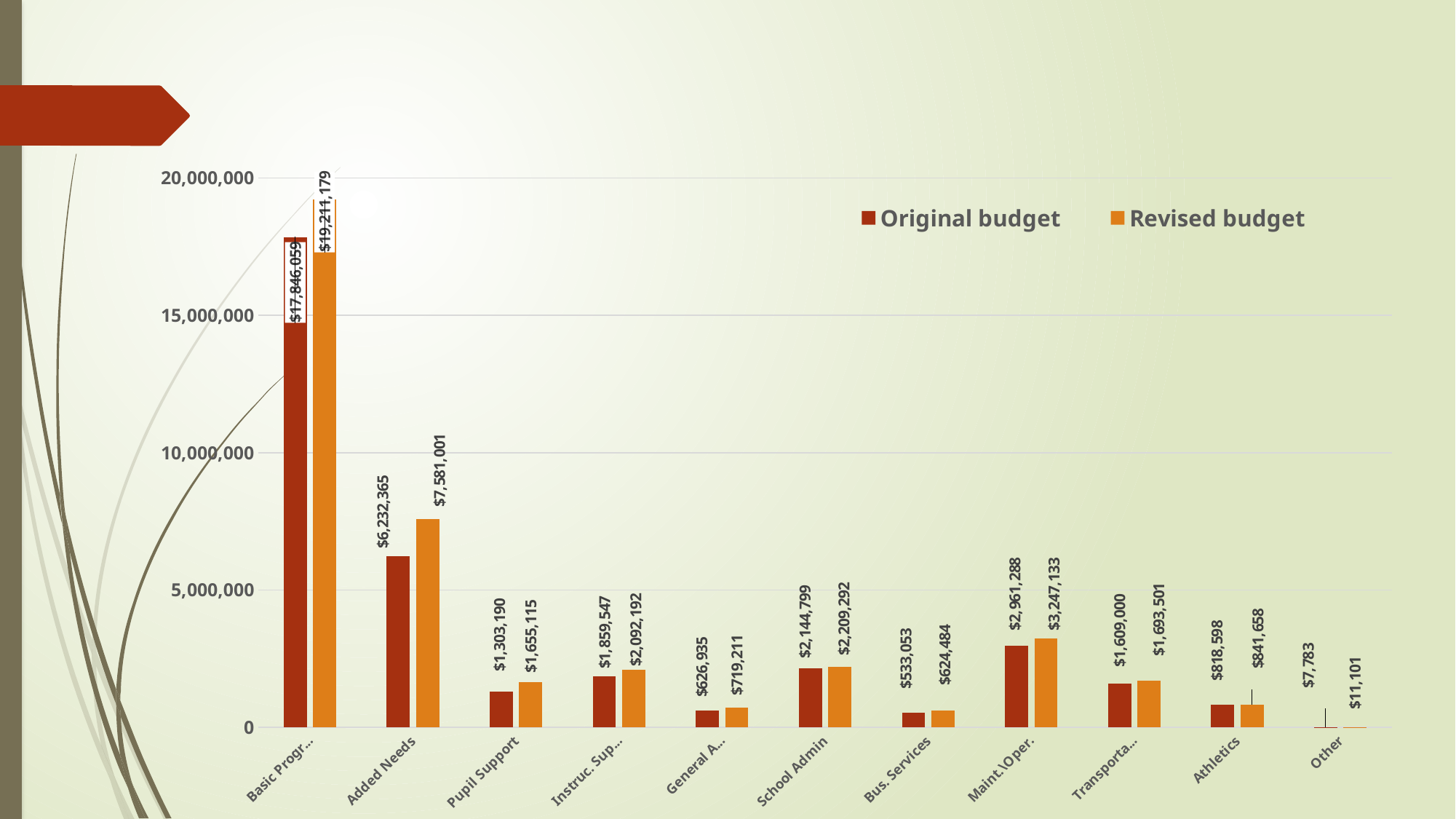
What is the difference between the Revised budget and the Original budget for Added Needs? $1,348,636 What is the Revised budget value for Pupil Support? $1,655,115 What kind of chart is shown on the slide? bar chart What is the Original budget value for Other? $7,783 Which category has the lowest Revised budget? Other How many series does the legend list? 2 What is the Original budget value for Added Needs? $6,232,365 How many categories are shown on the x axis? 11 Is the Revised budget for Added Needs greater or less than 5,000,000? greater Which is larger, the Original budget for Maint.\Oper. or the Original budget for School Admin? Maint.\Oper. What is the Revised budget value for Maint.\Oper.? $3,247,133 What is the difference between the Revised budget and the Original budget for Athletics? $23,060